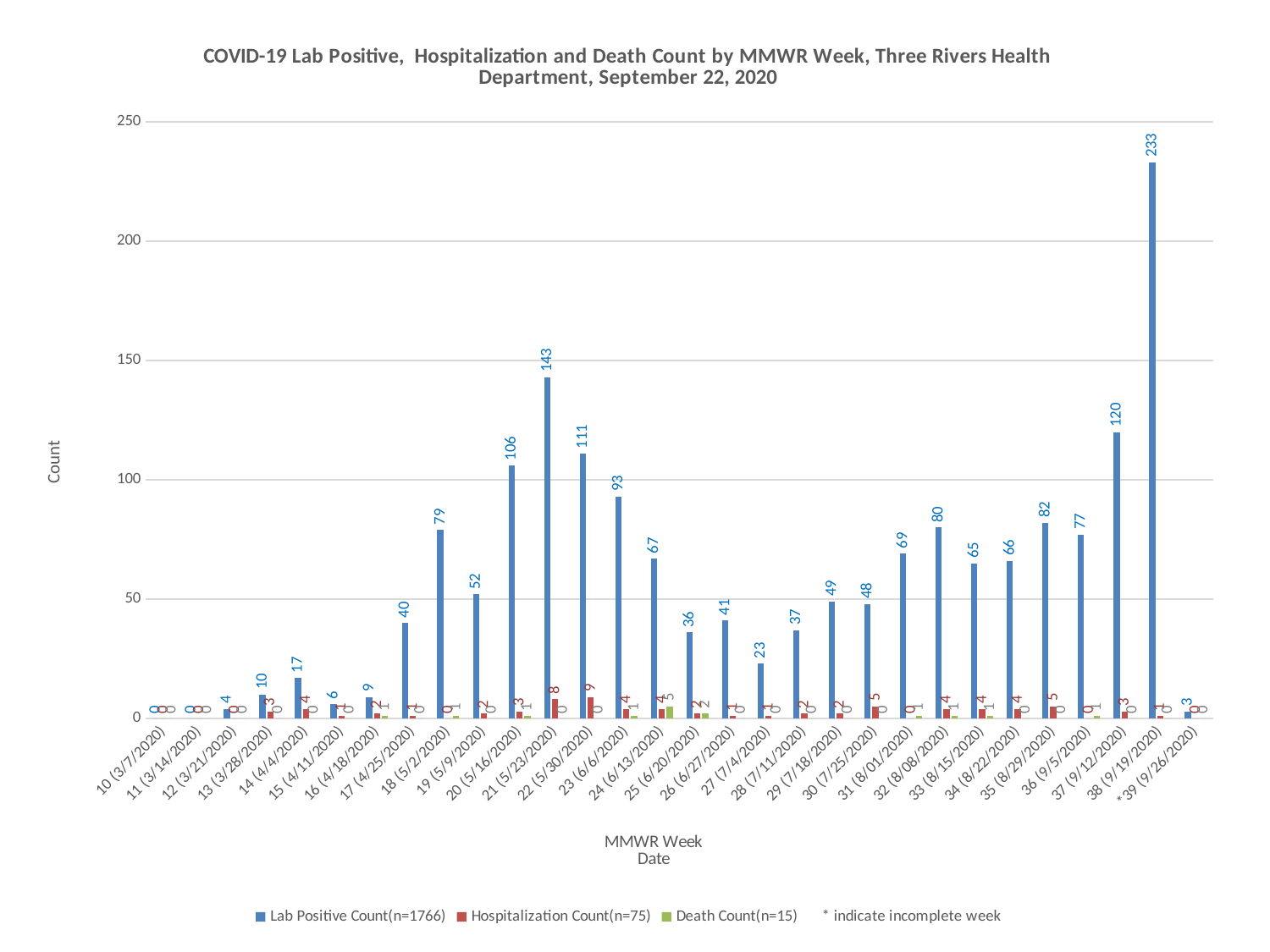
Is the Lab Positive Count for week 37 (9/12/2020) greater or less than 100? greater What is the Lab Positive Count for MMWR week 38 (9/19/2020)? 233 Which MMWR week has the highest Lab Positive Count? 38 (9/19/2020) Which has a larger Lab Positive Count, week 18 (5/2/2020) or week 19 (5/9/2020)? 18 (5/2/2020) How many series does the legend list? 3 What is the Hospitalization Count for MMWR week 22 (5/30/2020)? 9 What kind of chart is shown on the slide? bar chart How many MMWR weeks are shown on the x axis? 30 What is the difference between the Lab Positive Count in week 21 (5/23/2020) and week 20 (5/16/2020)? 37 According to the legend, what is the total n for the Hospitalization Count series? n=75 Which MMWR week has the highest Death Count? 24 (6/13/2020) What is the Death Count for MMWR week 24 (6/13/2020)? 5